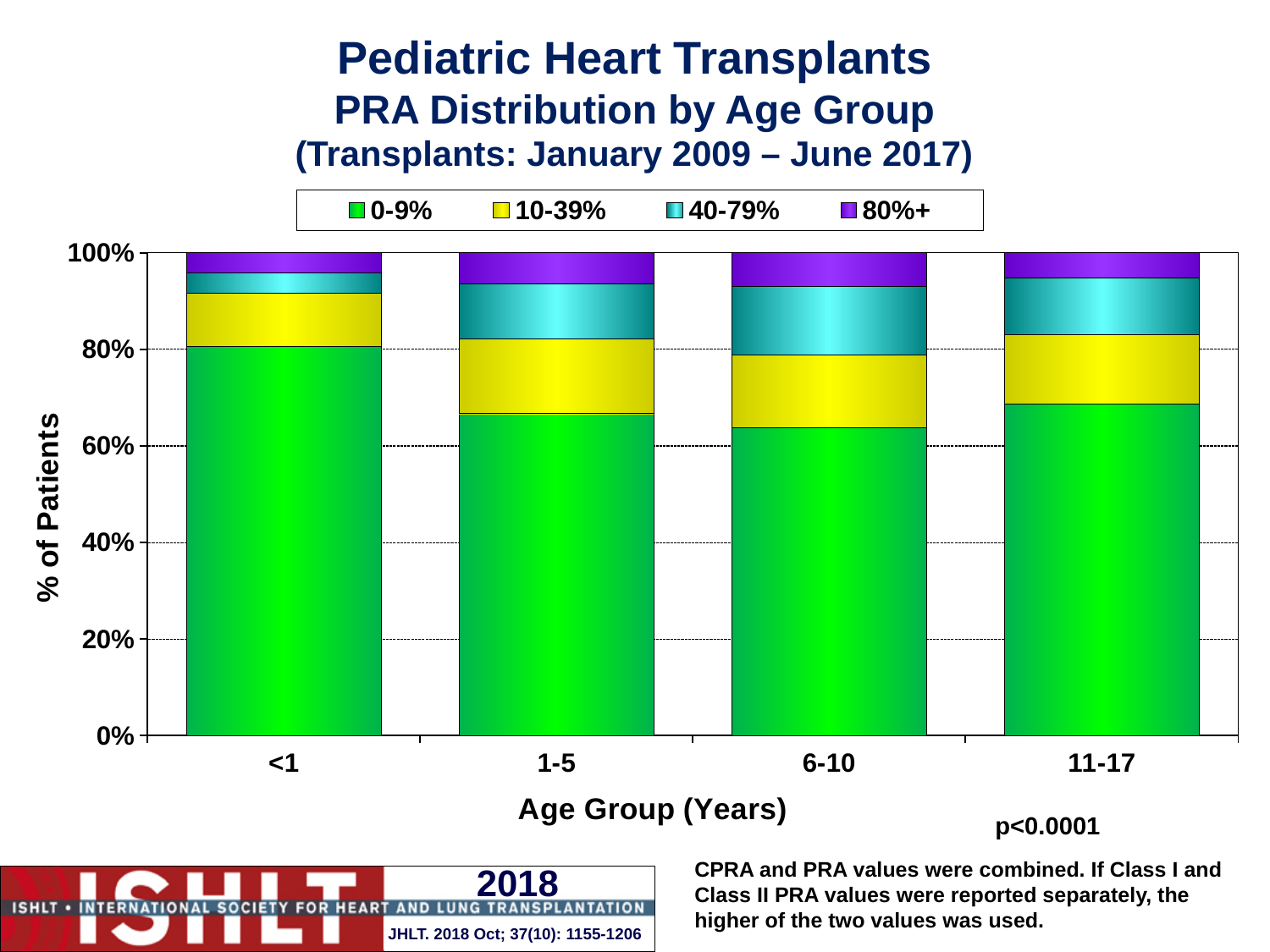
Which is larger: the 0-9% PRA share for the <1 age group or for the 6-10 age group? <1 Which age group has the largest 0-9% PRA segment? <1 Is the 0-9% PRA share for the 6-10 age group greater or less than 60%? greater What kind of chart is shown on the slide? Stacked bar chart What is the total height of each stacked bar? 100% Is the 0-9% PRA share for the 1-5 age group greater or less than 60%? greater Which age group has the smallest 40-79% PRA segment? <1 What is the label of the x axis? Age Group (Years) Is the 0-9% PRA share for the 11-17 age group greater or less than 80%? less What p-value is shown on the slide? p<0.0001 How many age groups are shown on the x axis? 4 How many PRA categories does the legend list? 4